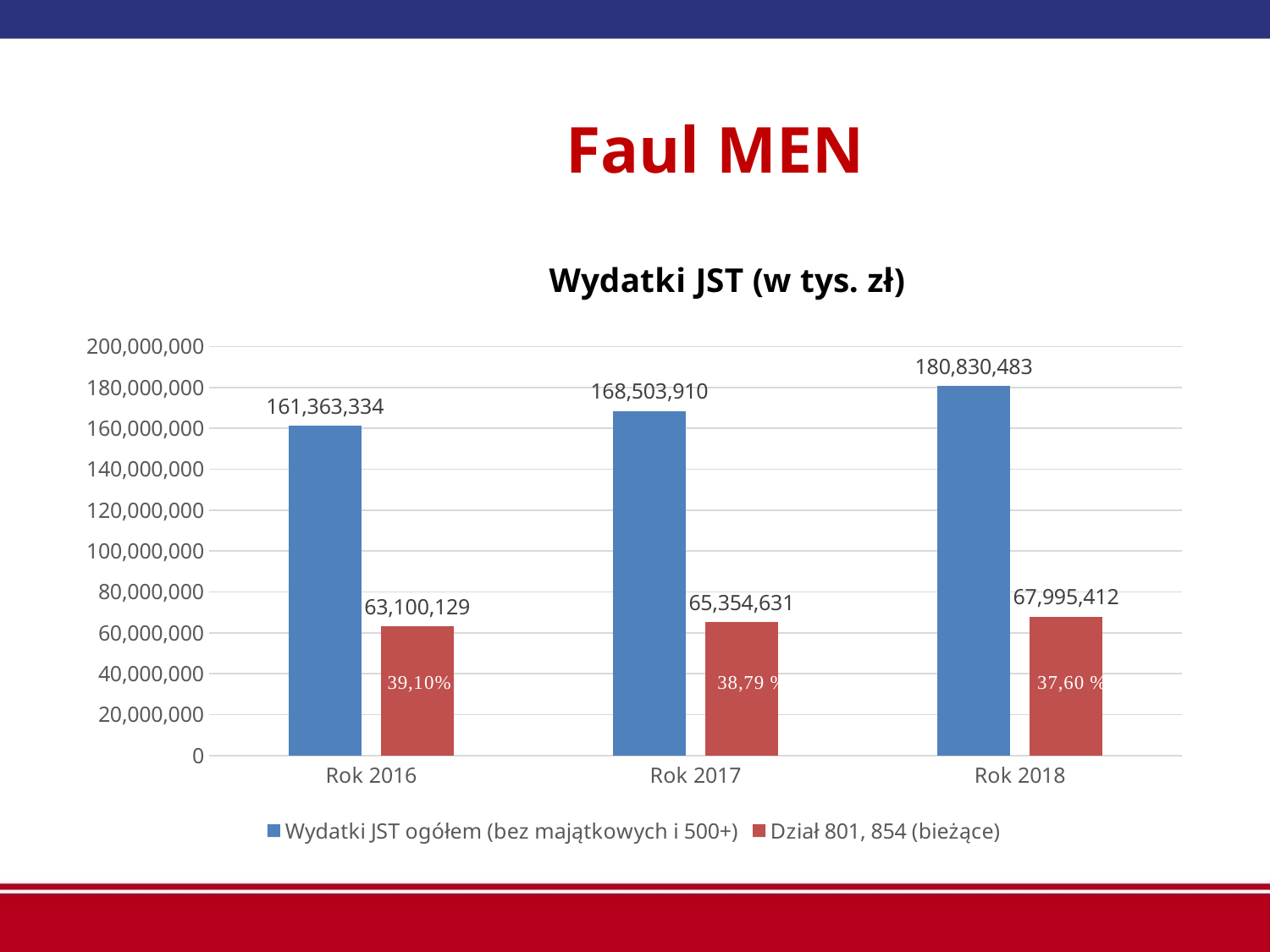
In which year is Wydatki JST ogółem (bez majątkowych i 500+) highest? Rok 2018 What is the value of Dział 801, 854 (bieżące) for Rok 2018? 67,995,412 In which year is Dział 801, 854 (bieżące) lowest? Rok 2016 Which is larger: Dział 801, 854 (bieżące) in Rok 2017 or in Rok 2018? Rok 2018 How many years are shown on the x axis? 3 What percentage label is shown inside the Dział 801, 854 (bieżące) bar for Rok 2016? 39,10% What is the value of Wydatki JST ogółem (bez majątkowych i 500+) for Rok 2016? 161,363,334 How many series does the legend list? 2 What type of chart is shown on the slide? bar chart What is the value of Wydatki JST ogółem (bez majątkowych i 500+) for Rok 2017? 168,503,910 What is the difference between Wydatki JST ogółem (bez majątkowych i 500+) in Rok 2018 and Rok 2016? 19,467,149 What is the difference between Wydatki JST ogółem (bez majątkowych i 500+) and Dział 801, 854 (bieżące) in Rok 2017? 103,149,279